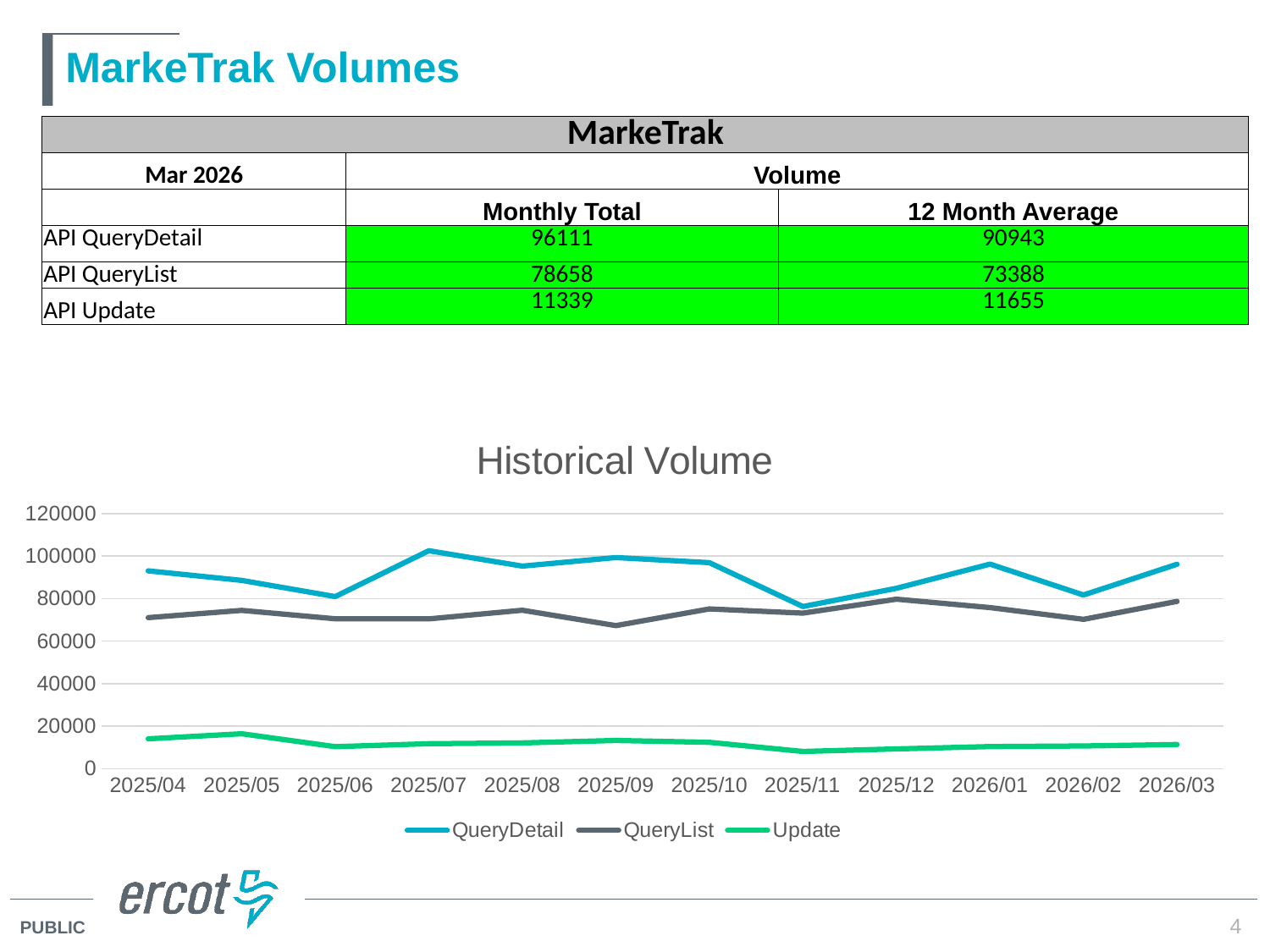
In the Historical Volume chart, is the QueryList value for 2025/09 greater or less than 60000? greater In the Historical Volume chart, is the Update value for 2025/04 greater or less than 20000? less How many months are plotted along the x axis of the Historical Volume chart? 12 Which series in the Historical Volume chart has the highest values across all months? QueryDetail Which series in the Historical Volume chart has the lowest values across all months? Update What is the title of the chart on the slide? Historical Volume In the Historical Volume chart, is the QueryDetail value for 2025/11 greater or less than 80000? less What kind of chart is the Historical Volume chart? line chart How many series does the legend of the Historical Volume chart list? 3 In the Historical Volume chart, which is larger at 2025/07: QueryDetail or QueryList? QueryDetail In the Historical Volume chart, does the Update series rise or fall from 2025/05 to 2025/11? fall In the Historical Volume chart, does the QueryDetail series rise or fall from 2025/11 to 2026/01? rise